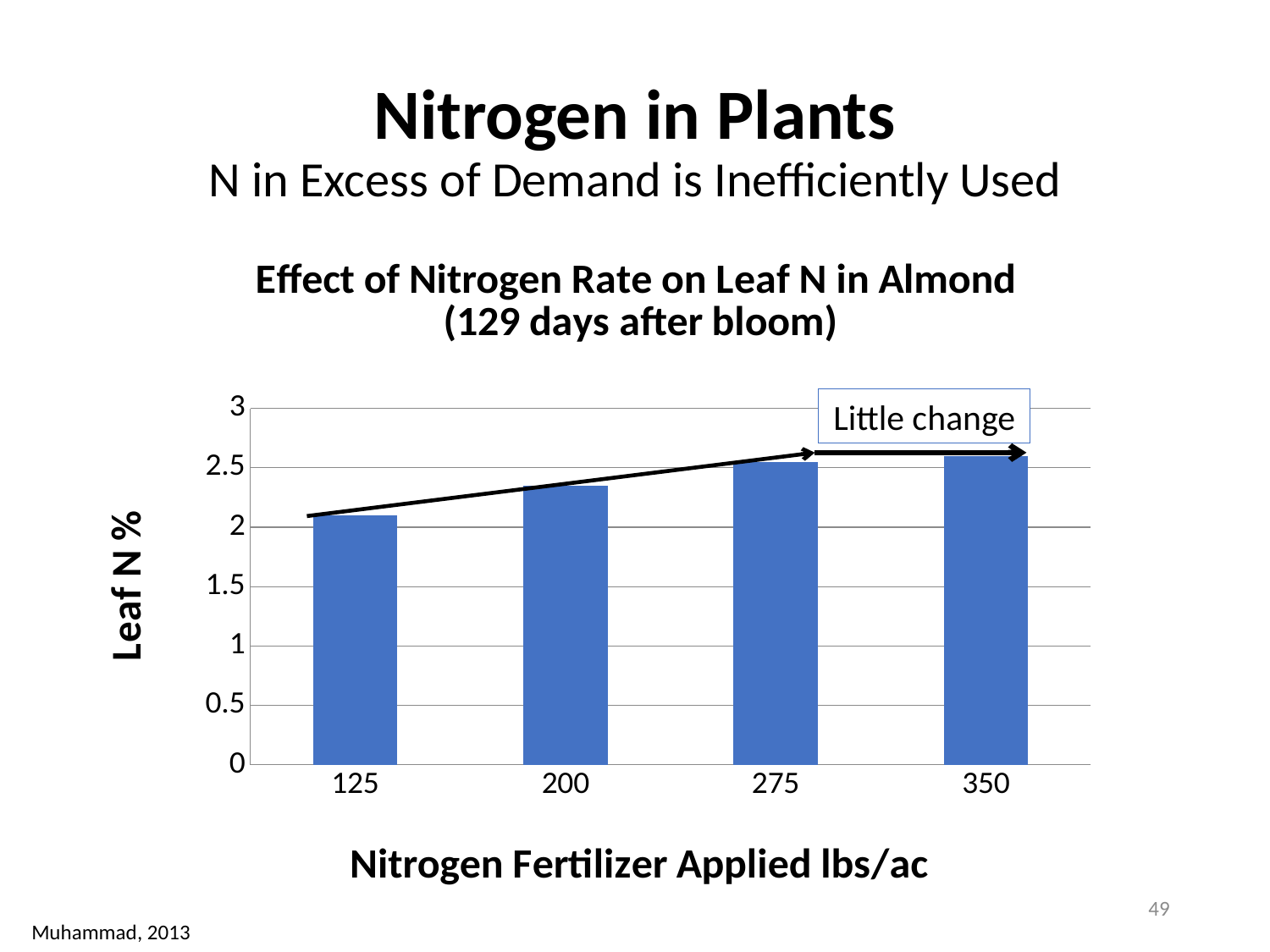
Which has a higher Leaf N %: the 200 lbs/ac rate or the 350 lbs/ac rate? 350 Is the Leaf N % for the 200 lbs/ac rate greater or less than 2? greater Is the Leaf N % for the 350 lbs/ac rate greater or less than 2? greater What is the title of the chart? Effect of Nitrogen Rate on Leaf N in Almond (129 days after bloom) What does the annotation box above the last two bars say? Little change Which has a higher Leaf N %: the 125 lbs/ac rate or the 275 lbs/ac rate? 275 Is the Leaf N % for the 275 lbs/ac rate greater or less than 3? less Do the Leaf N % values rise or fall as the nitrogen fertilizer rate increases from 125 to 350 lbs/ac? rise Which nitrogen fertilizer rate has the lowest Leaf N %? 125 What kind of chart is shown on the slide? bar chart How many nitrogen fertilizer rates (bars) are plotted in the chart? 4